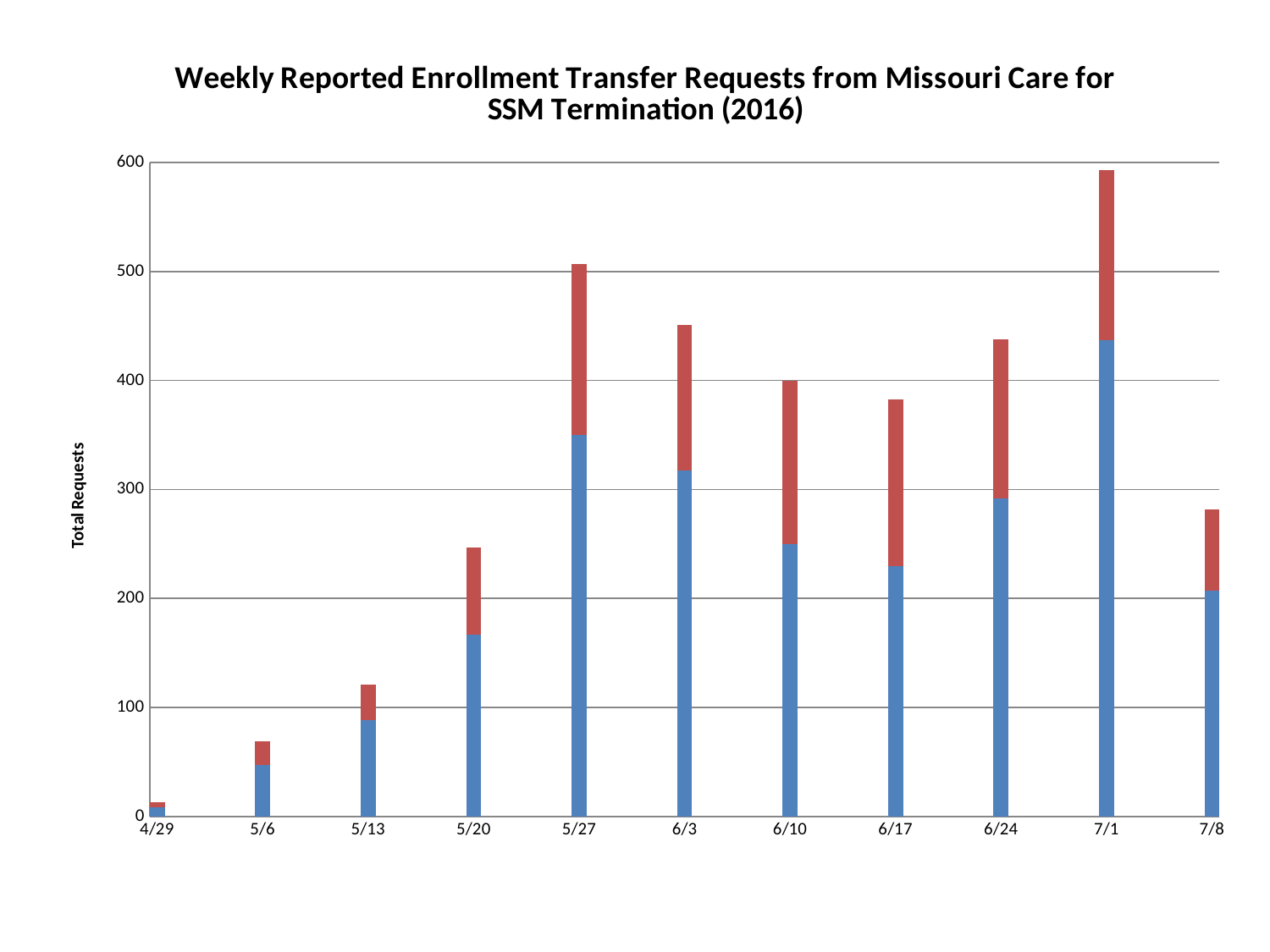
What is the label on the vertical axis? Total Requests Which week has a larger total, 6/24 or 7/8? 6/24 Is the total for 5/6 greater or less than 100? less Is the total for 7/8 greater or less than 300? less What kind of chart is shown on the slide? Stacked bar chart Which week has the highest total requests? 7/1 Do the totals rise or fall from 4/29 to 5/27? rise How many weekly dates are shown on the x axis? 11 Which week has a larger total, 5/27 or 6/3? 5/27 Which week has the lowest total requests? 4/29 Is the total for 6/17 greater or less than 400? less